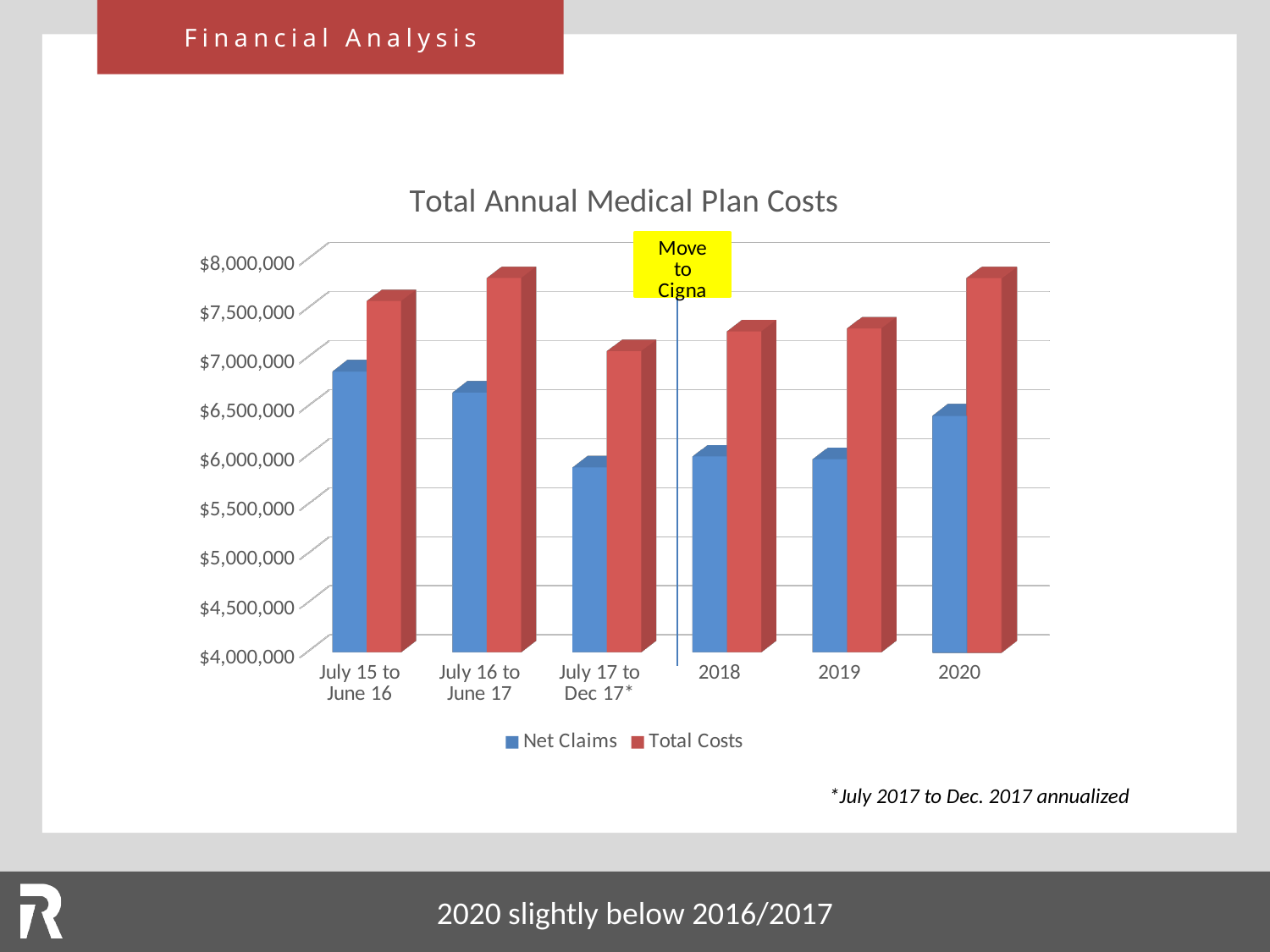
Which period has the lowest Total Costs? July 17 to Dec 17* Is the Total Costs value for July 17 to Dec 17* greater or less than $7,500,000? less Is the Net Claims value for 2018 greater or less than $6,500,000? less Which period has the highest Net Claims? July 15 to June 16 How many series does the legend list? 2 What is the title of the chart? Total Annual Medical Plan Costs What does the yellow annotation on the chart say? Move to Cigna What kind of chart is shown on the slide? Bar chart How many periods are shown along the x axis? 6 Which is larger: Net Claims for July 15 to June 16 or Net Claims for 2020? July 15 to June 16 Is the Net Claims value for July 15 to June 16 greater or less than $6,500,000? greater